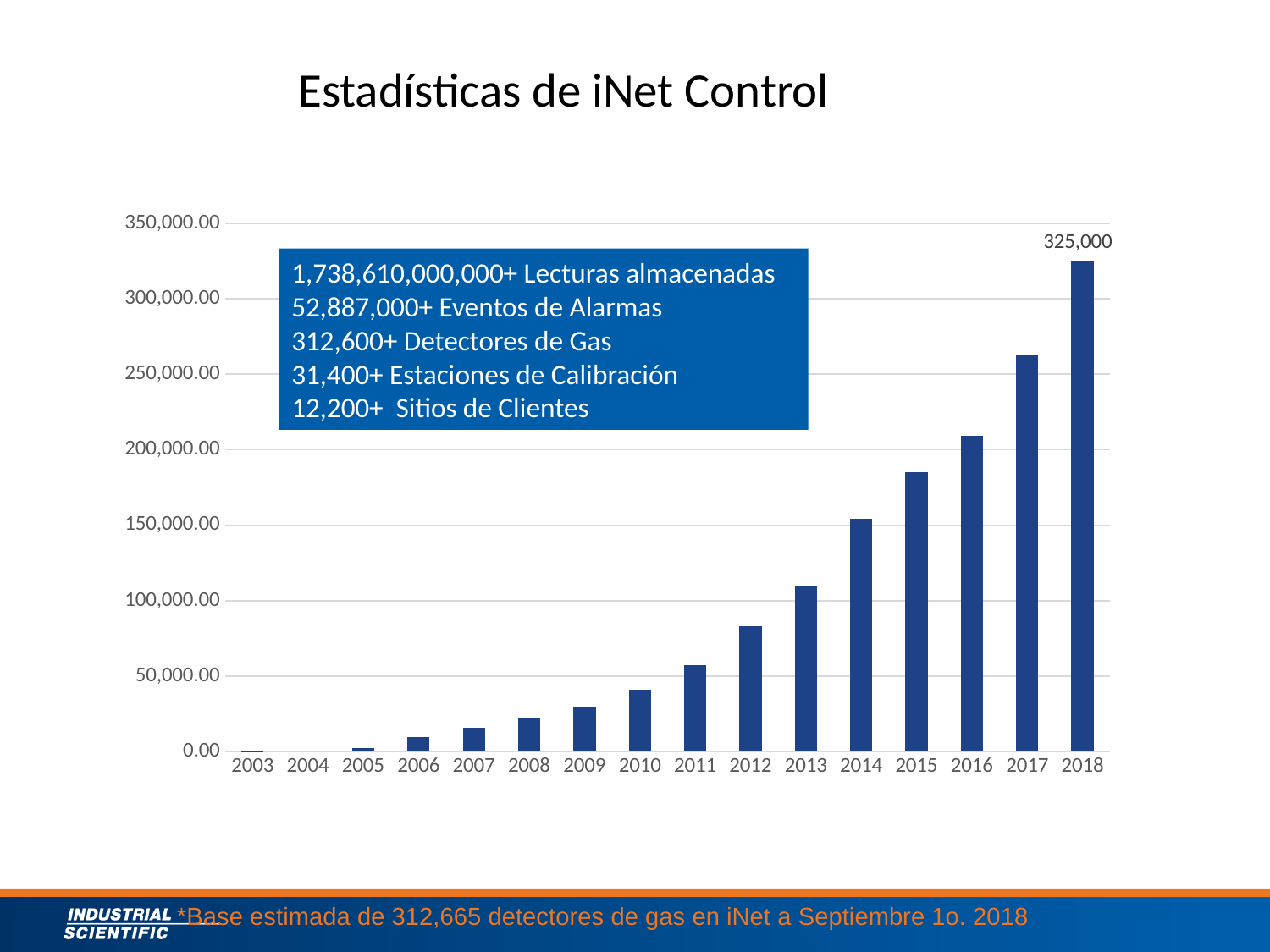
Which year has the highest bar? 2018 Is the value for 2010 greater or less than 50,000? less Is the value for 2017 greater or less than 250,000? greater Is the value for 2012 greater or less than 100,000? less How many years are shown on the x axis of the chart? 16 What is the value shown for 2018? 325,000 What is the title of the slide containing the chart? Estadísticas de iNet Control Which year has the larger value, 2016 or 2017? 2017 What colour are the bars in the chart? blue Do the values generally rise or fall from 2003 to 2018? rise What type of chart is shown on the slide? bar chart